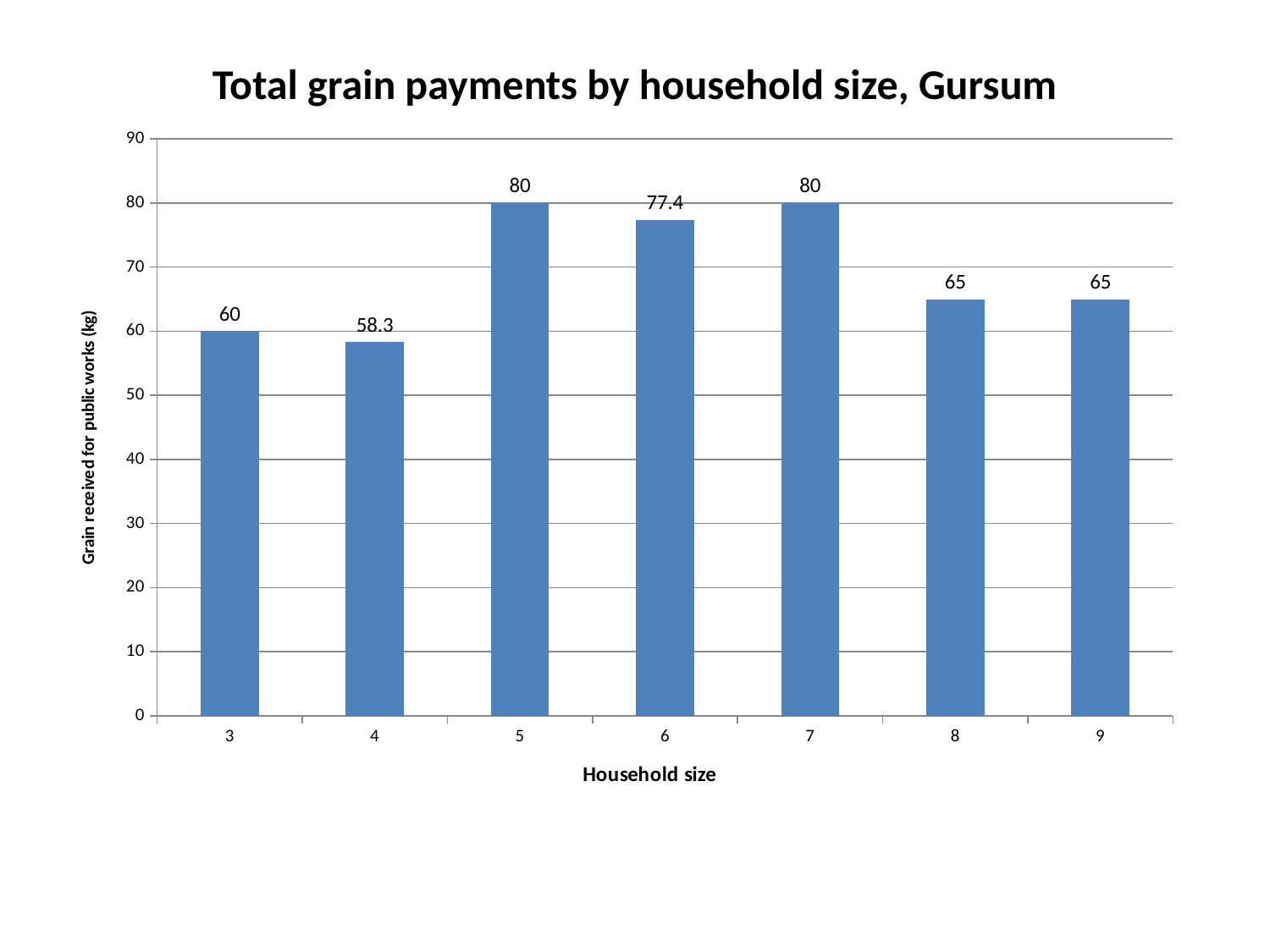
What is the grain received for public works for household size 4? 58.3 Which is larger, the grain payment for household size 3 or for household size 9? household size 9 What is the highest grain payment value shown on the chart? 80 What is the title of the chart? Total grain payments by household size, Gursum What is the difference between the grain payments for household size 5 and household size 3? 20 What is the difference between the grain payments for household size 7 and household size 6? 2.6 What kind of chart is shown on the slide? bar chart What is the grain received for public works for household size 8? 65 How many household size categories are shown on the chart? 7 Is the grain payment for household size 6 greater or less than 70? greater What is the grain received for public works for household size 6? 77.4 Which household size has the lowest grain payment? 4